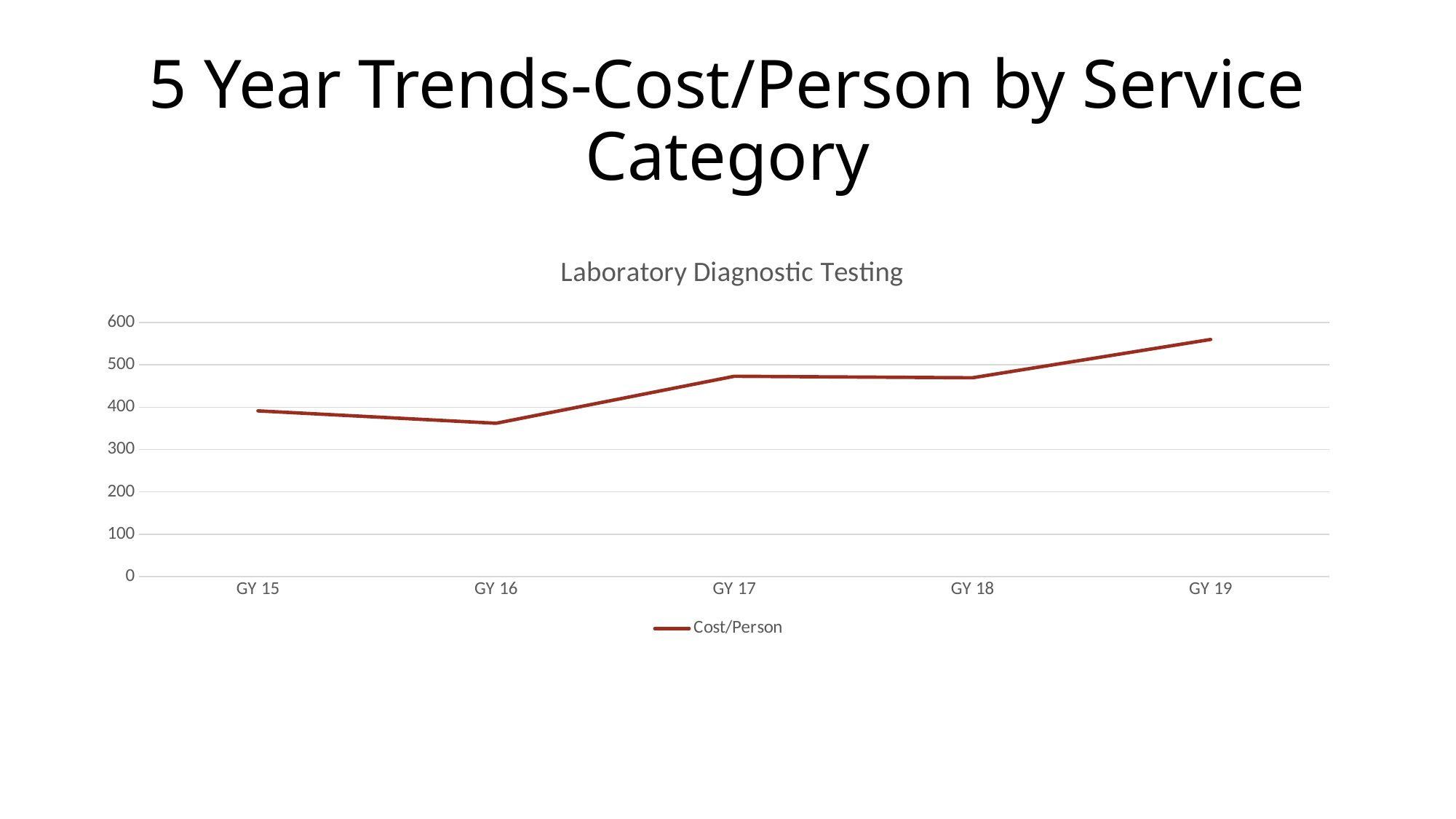
How many series does the legend list? 1 Is the Cost/Person for GY 16 greater or less than 400? less Is the Cost/Person for GY 17 greater or less than 500? less What type of chart is shown on the slide? Line chart What is the name of the series shown in the legend? Cost/Person How many years are plotted on the x axis? 5 Is the Cost/Person for GY 19 greater or less than 500? greater What is the title of the chart? Laboratory Diagnostic Testing Which year has the highest Cost/Person? GY 19 Which year has the lowest Cost/Person? GY 16 Overall, does the Cost/Person rise or fall from GY 15 to GY 19? rise Which is larger, the Cost/Person for GY 15 or for GY 16? GY 15